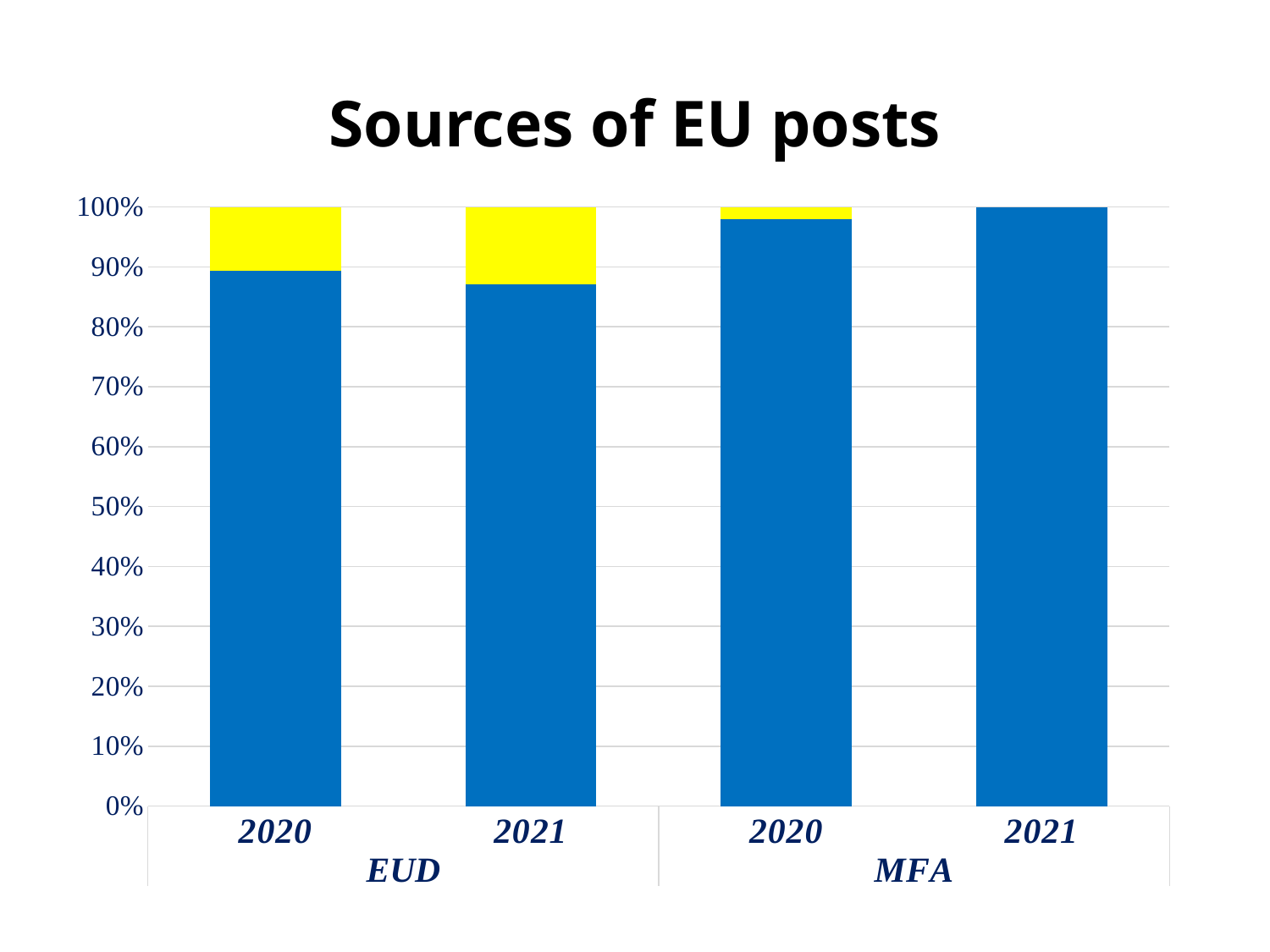
Is the blue segment for EUD 2021 greater or less than 90%? less Is the yellow segment larger for EUD 2020 or EUD 2021? EUD 2021 Which bar has the smallest blue segment? EUD 2021 Does the blue share for EUD rise or fall from 2020 to 2021? fall Is the blue segment for MFA 2020 greater or less than 90%? greater What is the total height of the EUD 2020 stacked bar? 100% Is the blue segment for EUD 2020 greater or less than 80%? greater Which group, EUD or MFA, is shown on the right side of the chart? MFA What kind of chart is shown on the slide? stacked bar chart How many bars are plotted in the chart? 4 What is the title of the chart? Sources of EU posts Which bar has the largest yellow segment? EUD 2021